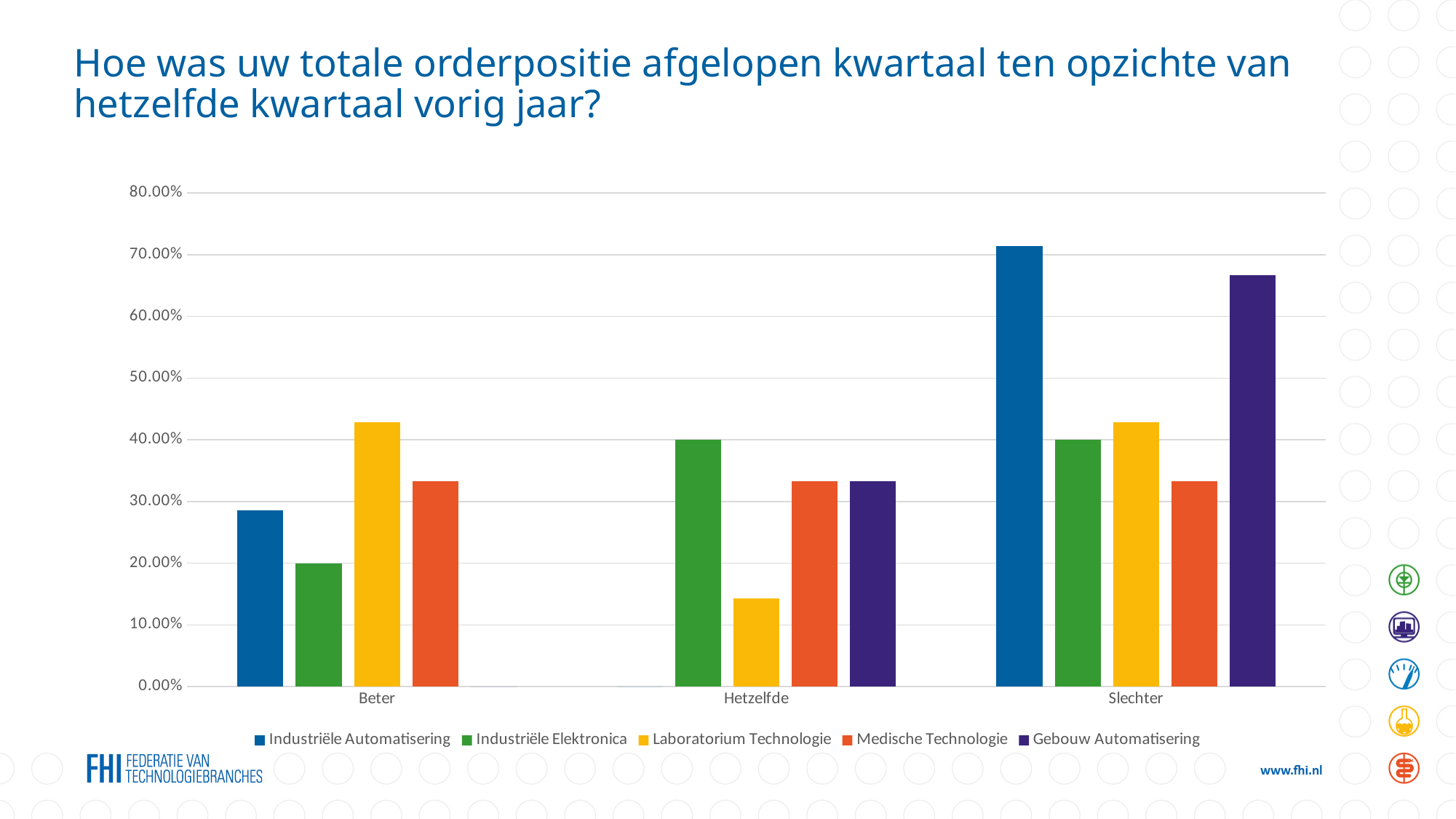
How many series does the legend list? 5 In the Slechter category, which is larger: Gebouw Automatisering or Industriële Elektronica? Gebouw Automatisering Which series has the highest bar in the Beter category? Laboratorium Technologie What is the value for Industriële Elektronica in the Beter category? 20.00% What is the value for Industriële Elektronica in the Hetzelfde category? 40.00% How many categories are shown on the x axis? 3 Is the value for Industriële Automatisering in the Slechter category greater or less than 70.00%? greater Which colour represents Laboratorium Technologie in the legend? yellow Which series has the lowest bar in the Hetzelfde category? Industriële Automatisering Which series has the highest bar in the Slechter category? Industriële Automatisering Is the value for Laboratorium Technologie in the Hetzelfde category greater or less than 20.00%? less What kind of chart is shown on the slide? bar chart